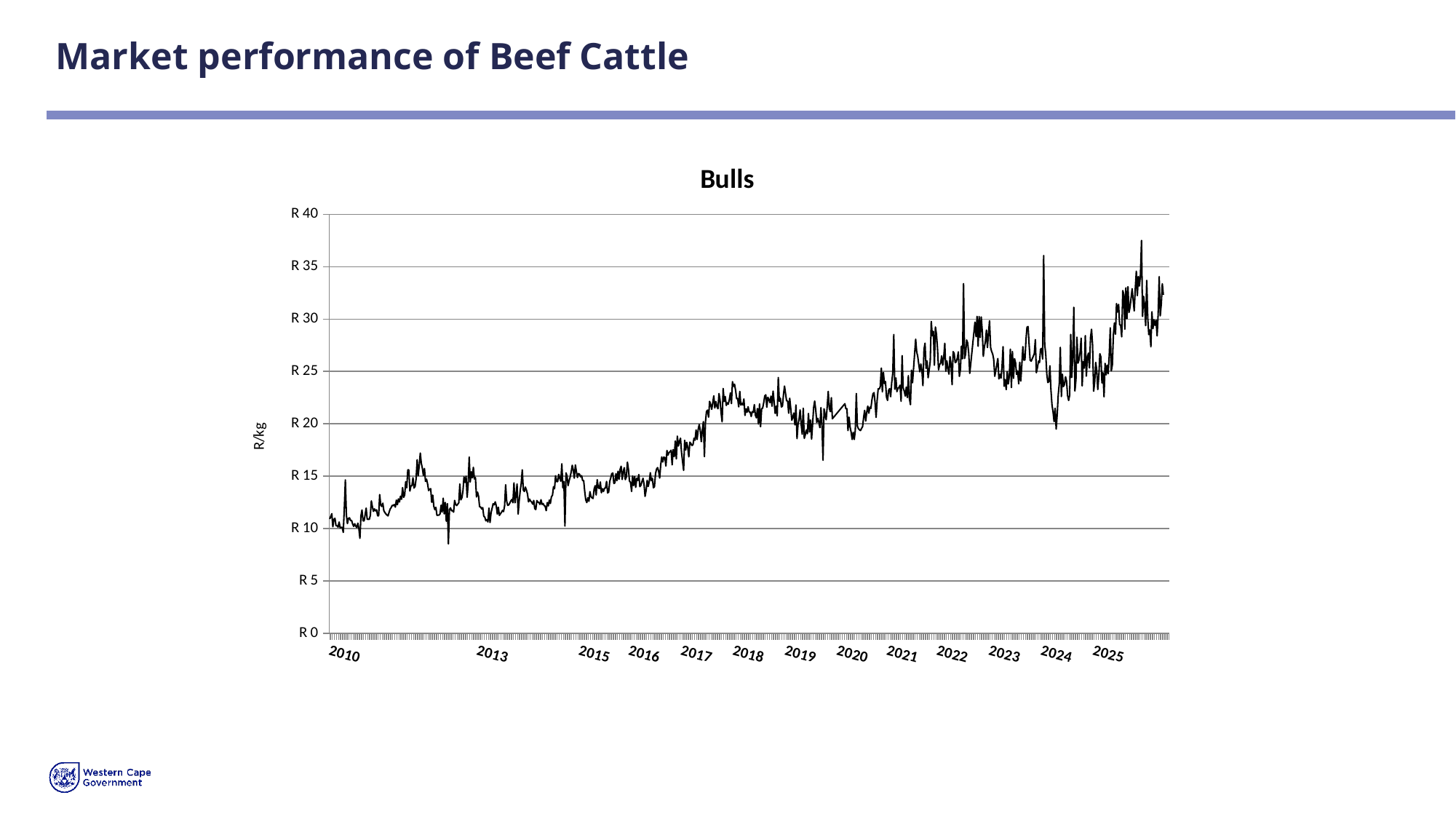
Is the value for Bulls in 2010 greater or less than R 20? less How many data series are plotted in the chart? 1 Is the value for Bulls in 2017 greater or less than R 15? greater What kind of chart is shown on the slide? line chart What is the title of the chart? Bulls Is the value for Bulls in 2021 greater or less than R 20? greater What is the label on the vertical axis of the chart? R/kg Overall, do the values in the Bulls chart rise or fall from 2010 to 2025? rise Is the value for Bulls in 2025 higher or lower than in 2010? higher